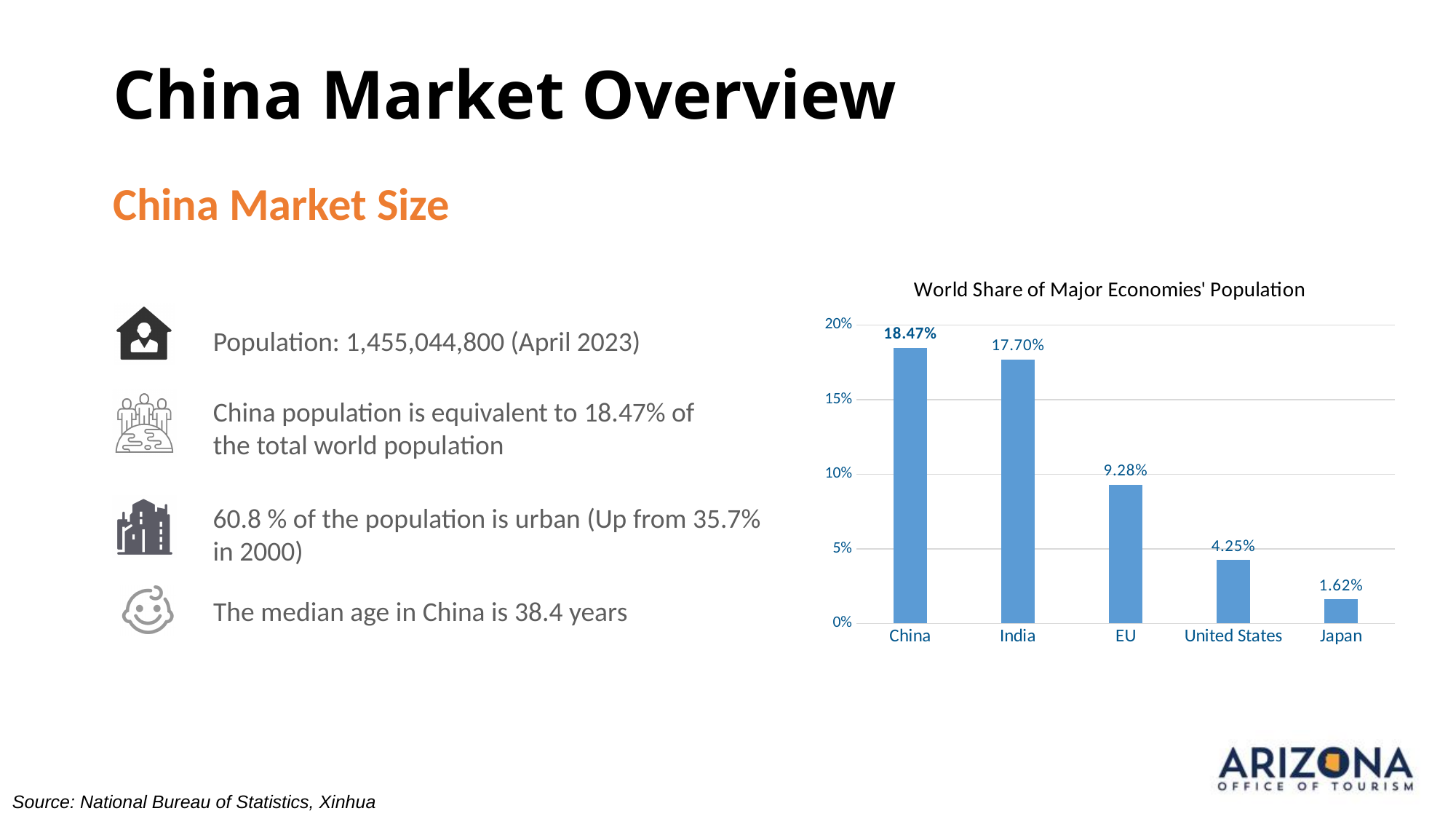
What is the world population share shown for China? 18.47% Which economy has the lowest world population share in the chart? Japan Which has a larger world population share, the EU or the United States? EU What is the difference in world population share between China and India? 0.77% What is the world population share shown for India? 17.70% What type of chart is used to show the world share of major economies' population? Bar chart What is the world population share shown for the United States? 4.25% How many economies are shown in the chart? 5 What is the world population share shown for Japan? 1.62% What is the title of the chart? World Share of Major Economies' Population What is the world population share shown for the EU? 9.28% Which economy has the highest world population share in the chart? China